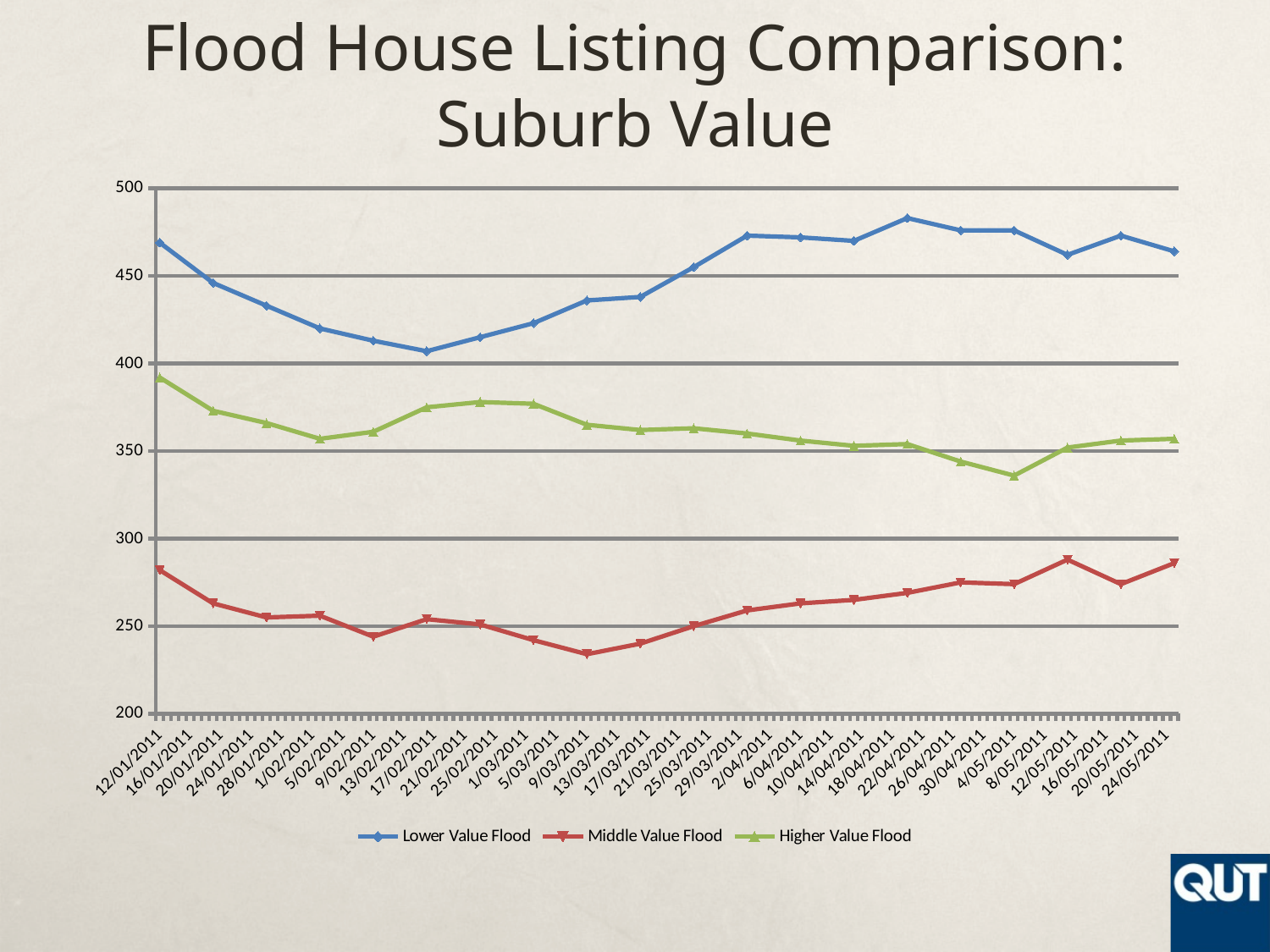
Is the value for Middle Value Flood on 9/03/2011 greater or less than 250? less What kind of chart is shown on the slide? Line chart Is the value for Lower Value Flood on 12/01/2011 greater or less than 450? greater Is the value for Middle Value Flood on 12/05/2011 greater or less than 250? greater Which series has the highest values across the whole period? Lower Value Flood On 24/05/2011, which is larger: Higher Value Flood or Middle Value Flood? Higher Value Flood How many series does the legend list? 3 What colour is the Higher Value Flood line? Green Does the Lower Value Flood line rise or fall from 12/01/2011 to 17/02/2011? fall Which series has the lowest values across the whole period? Middle Value Flood